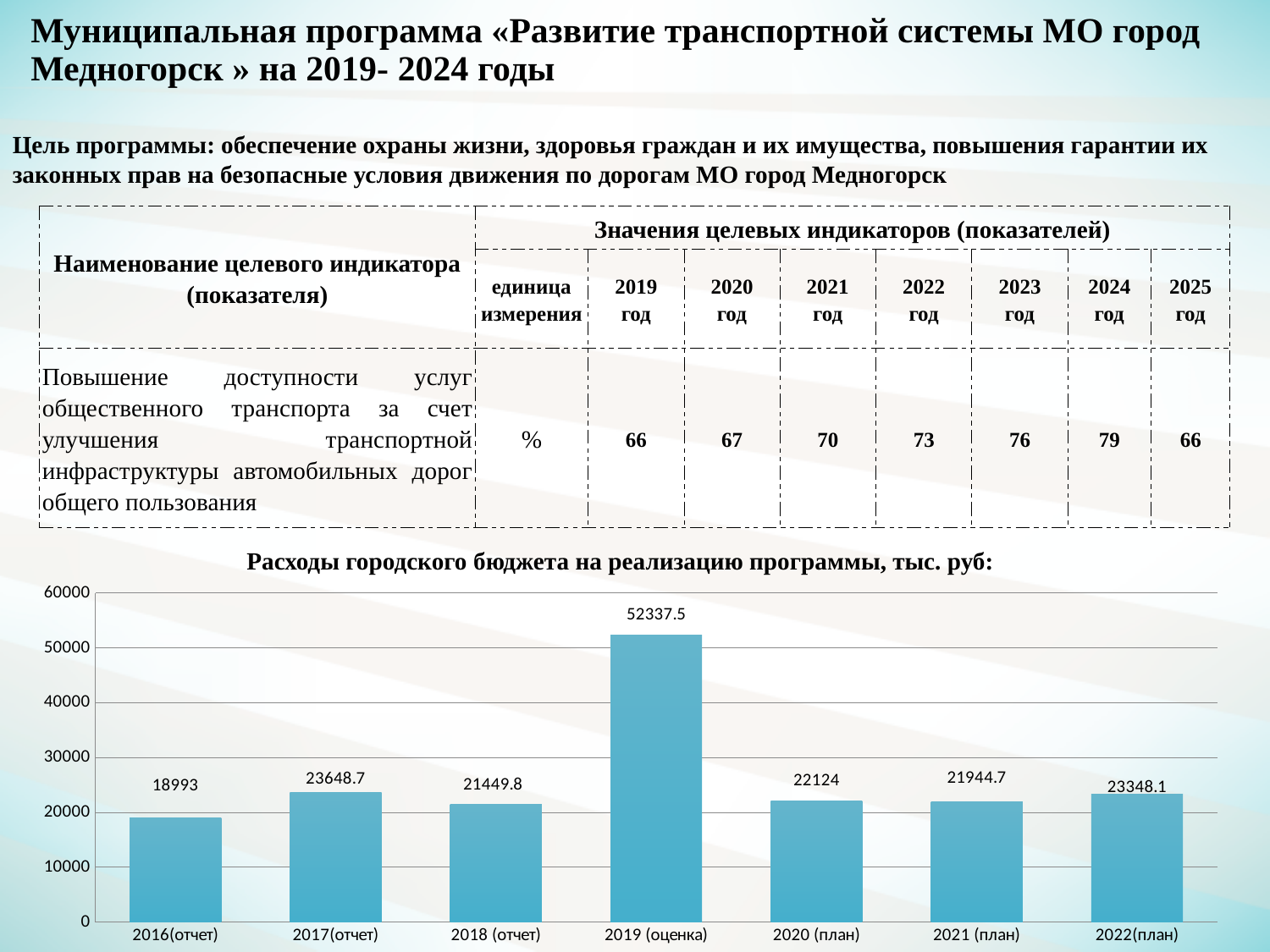
What is the value for 2022(план) in the chart? 23348.1 What is the value for 2019 (оценка) in the chart 'Расходы городского бюджета на реализацию программы, тыс. руб'? 52337.5 Which category has the highest value in the chart? 2019 (оценка) What is the title of the chart on the slide? Расходы городского бюджета на реализацию программы, тыс. руб: How many categories are shown on the x axis of the chart? 7 What is the value for 2016(отчет) in the chart? 18993 What is the difference between the values for 2017(отчет) and 2016(отчет)? 4655.7 Is the value for 2021 (план) greater or less than 30000? less What is the difference between the values for 2019 (оценка) and 2020 (план)? 30213.5 Which is larger, the value for 2017(отчет) or the value for 2018 (отчет)? 2017(отчет) What kind of chart is shown on the slide? bar chart Which category has the lowest value in the chart? 2016(отчет)